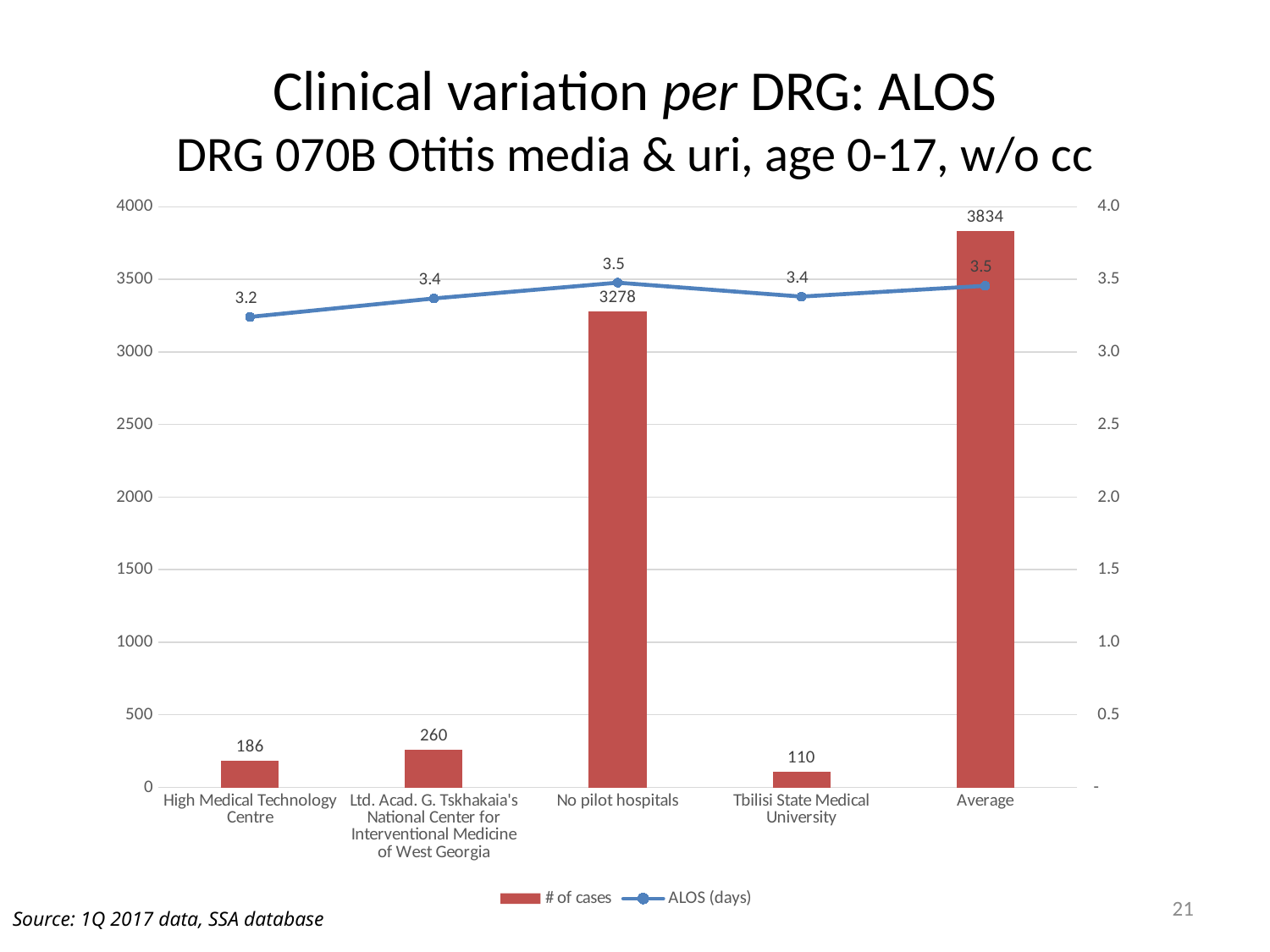
What kind of chart is used to show the # of cases series? Bar chart How many categories are shown on the x axis? 5 What is the difference in ALOS (days) between No pilot hospitals and High Medical Technology Centre? 0.3 How many cases are shown for No pilot hospitals? 3278 Which category has the lowest number of cases? Tbilisi State Medical University How many cases are shown for Tbilisi State Medical University? 110 How many series does the legend list? 2 Which has more cases, High Medical Technology Centre or Ltd. Acad. G. Tskhakaia's National Center for Interventional Medicine of West Georgia? Ltd. Acad. G. Tskhakaia's National Center for Interventional Medicine of West Georgia Which category has the highest number of cases? Average What is the ALOS (days) for the Average category? 3.5 What is the ALOS (days) for High Medical Technology Centre? 3.2 What is the difference in number of cases between Average and No pilot hospitals? 556